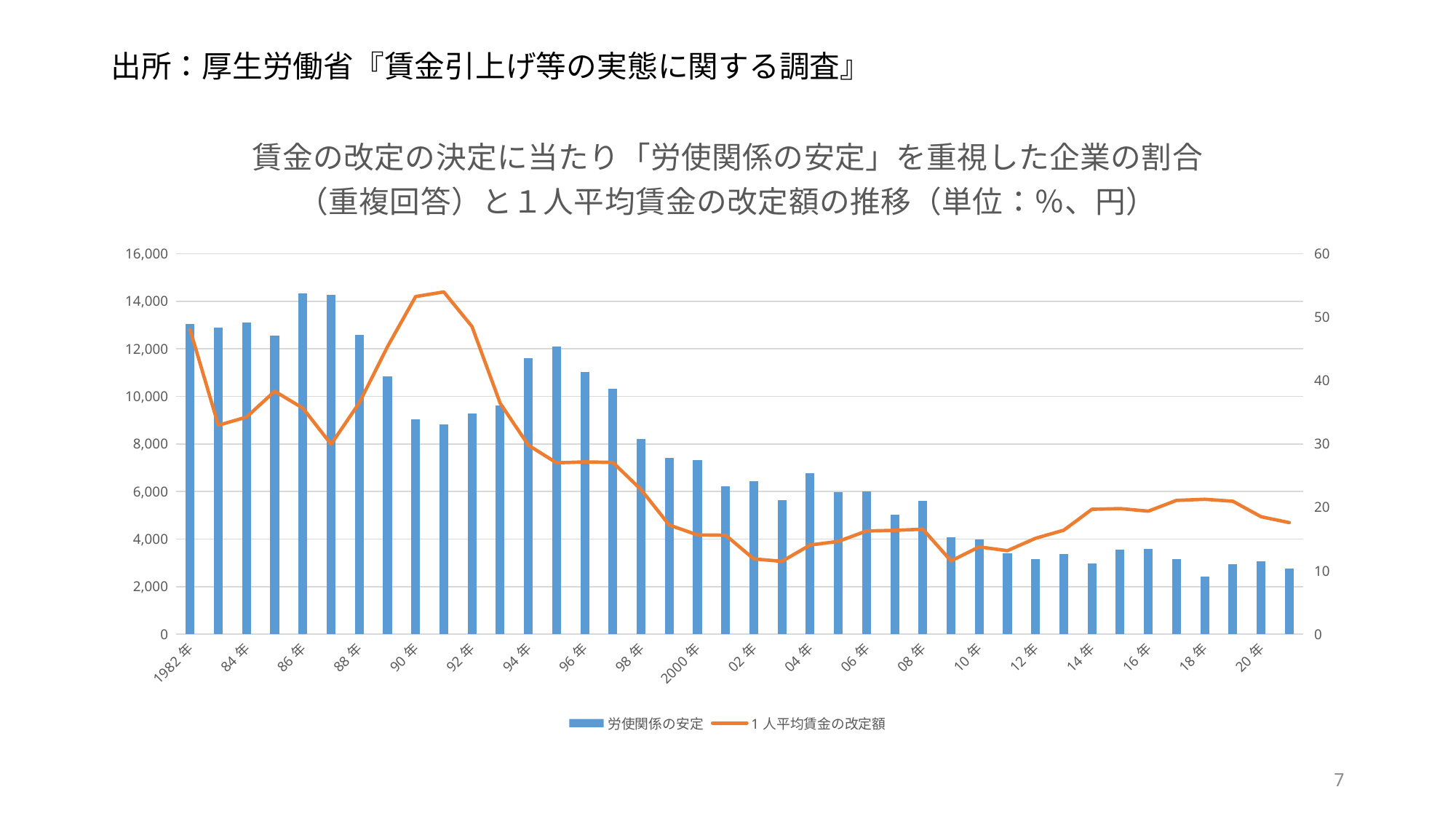
Which series is drawn as the orange line? １人平均賃金の改定額 Is the bar for 労使関係の安定 taller in 1995年 or in 2005年? 1995年 Is the １人平均賃金の改定額 line higher in 1991年 or in 2021年? 1991年 How many bars are plotted in the chart? 40 How many series does the legend list? 2 What is the first year shown on the x axis? 1982年 What kind of chart is shown on the slide? A combined bar and line chart Overall, do the bars for 労使関係の安定 rise or fall from 1982年 to 2021年? Fall Which year has the lowest bar for 労使関係の安定? 18年 Which series is drawn as bars? 労使関係の安定 Does the １人平均賃金の改定額 line rise or fall between 1991年 and 2003年? Fall Is the bar for 労使関係の安定 taller in 1982年 or in 2021年? 1982年